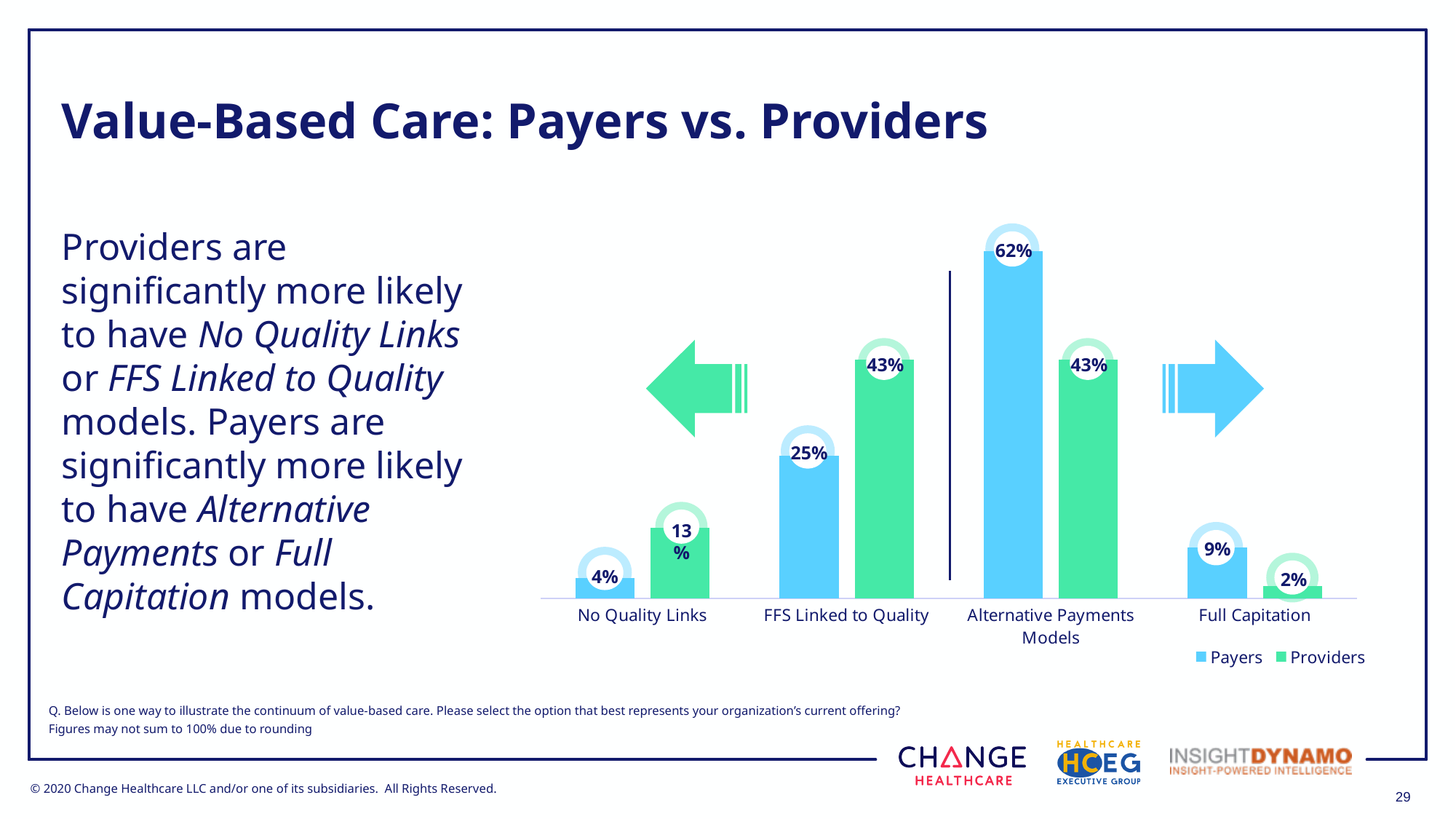
What is the value for Payers in the No Quality Links category? 4% Which category has the highest value for Payers? Alternative Payments Models In the FFS Linked to Quality category, which is larger, the Payers value or the Providers value? Providers What is the difference between the Payers and Providers values in the Alternative Payments Models category? 19% What is the value for Payers in the Alternative Payments Models category? 62% What is the value for Providers in the FFS Linked to Quality category? 43% What is the value for Providers in the Full Capitation category? 2% How many series does the legend list? 2 Which category has the lowest value for Providers? Full Capitation How many categories are shown on the x axis? 4 Which colour represents the Providers series in the chart? Green What kind of chart is shown on the slide? Bar chart